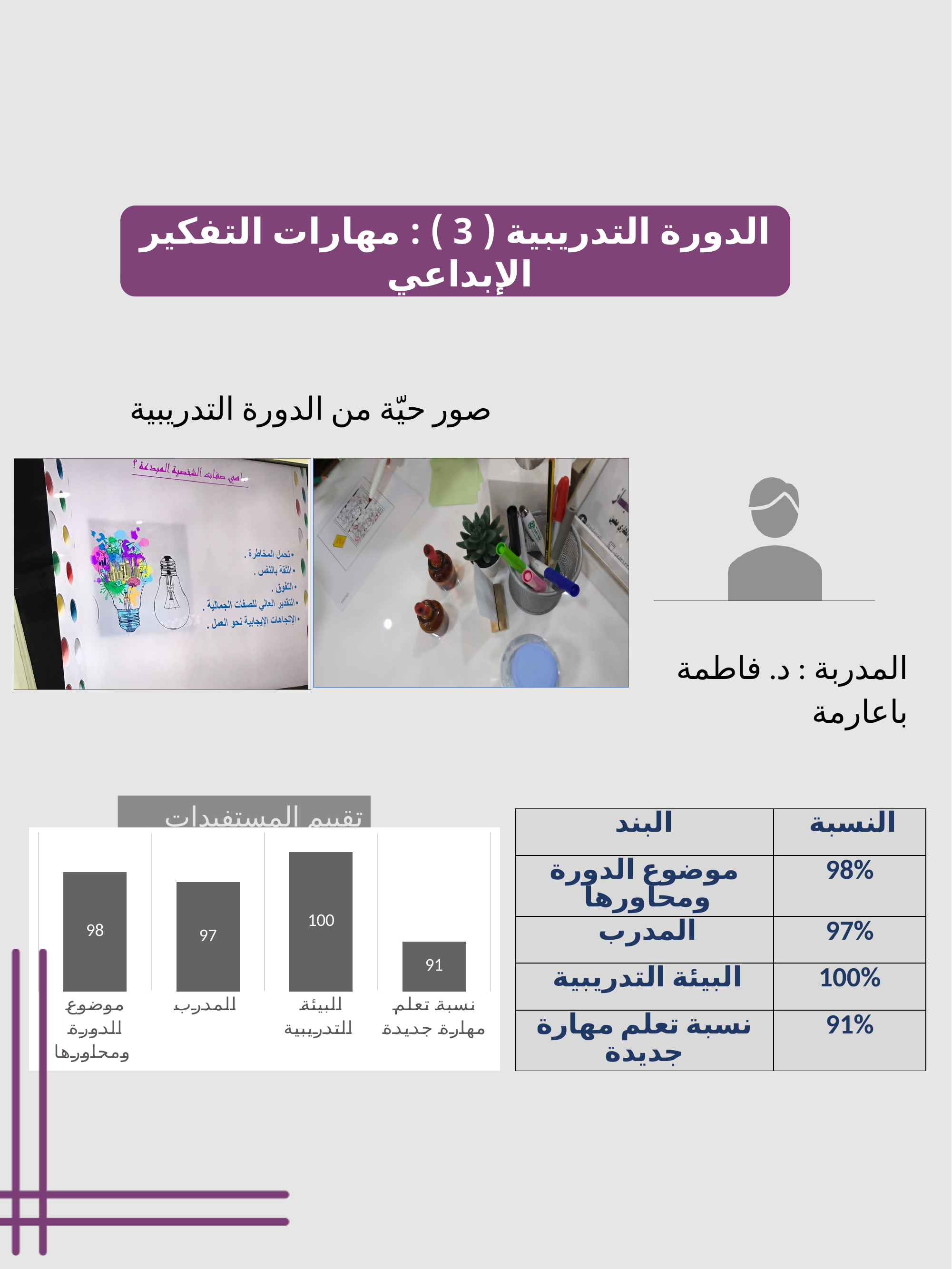
What is the value of the bar for المدرب? 97 What is the value of the bar for موضوع الدورة ومحاورها? 98 Which is larger: the value for المدرب or the value for نسبة تعلم مهارة جديدة? المدرب Which category has the lowest bar in the chart? نسبة تعلم مهارة جديدة What is the value of the bar for نسبة تعلم مهارة جديدة? 91 What is the title of the chart? تقيم المستفيدات What is the difference between the values for البيئة التدريبية and نسبة تعلم مهارة جديدة? 9 What is the value of the bar for البيئة التدريبية? 100 Which category has the highest bar in the chart? البيئة التدريبية What is the difference between the values for موضوع الدورة ومحاورها and المدرب? 1 How many bars (categories) does the chart show? 4 What type of chart is shown on the slide? Bar chart